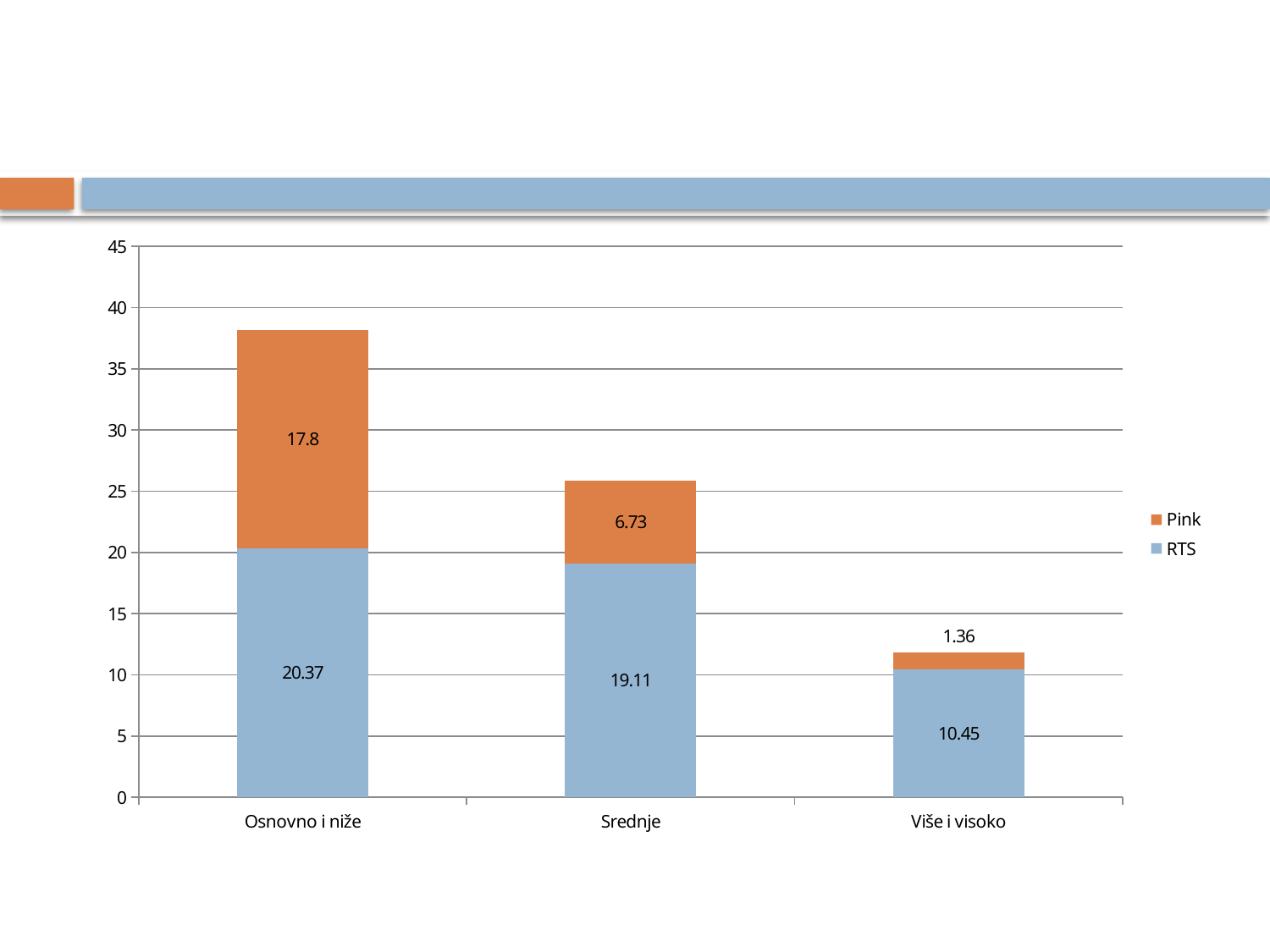
What is the difference between the RTS value for Srednje and the RTS value for Više i visoko? 8.66 What kind of chart is shown on the slide? stacked bar chart How many categories are shown on the x axis? 3 What is the RTS value for Osnovno i niže? 20.37 What is the Pink value for Srednje? 6.73 Which is larger for Srednje, the RTS value or the Pink value? RTS What is the total of the stacked bar for Više i visoko? 11.81 Which category has the lowest RTS value? Više i visoko Is the total stacked bar for Osnovno i niže greater or less than 35? greater How many series does the legend list? 2 Which category has the highest Pink value? Osnovno i niže What is the Pink value for Više i visoko? 1.36